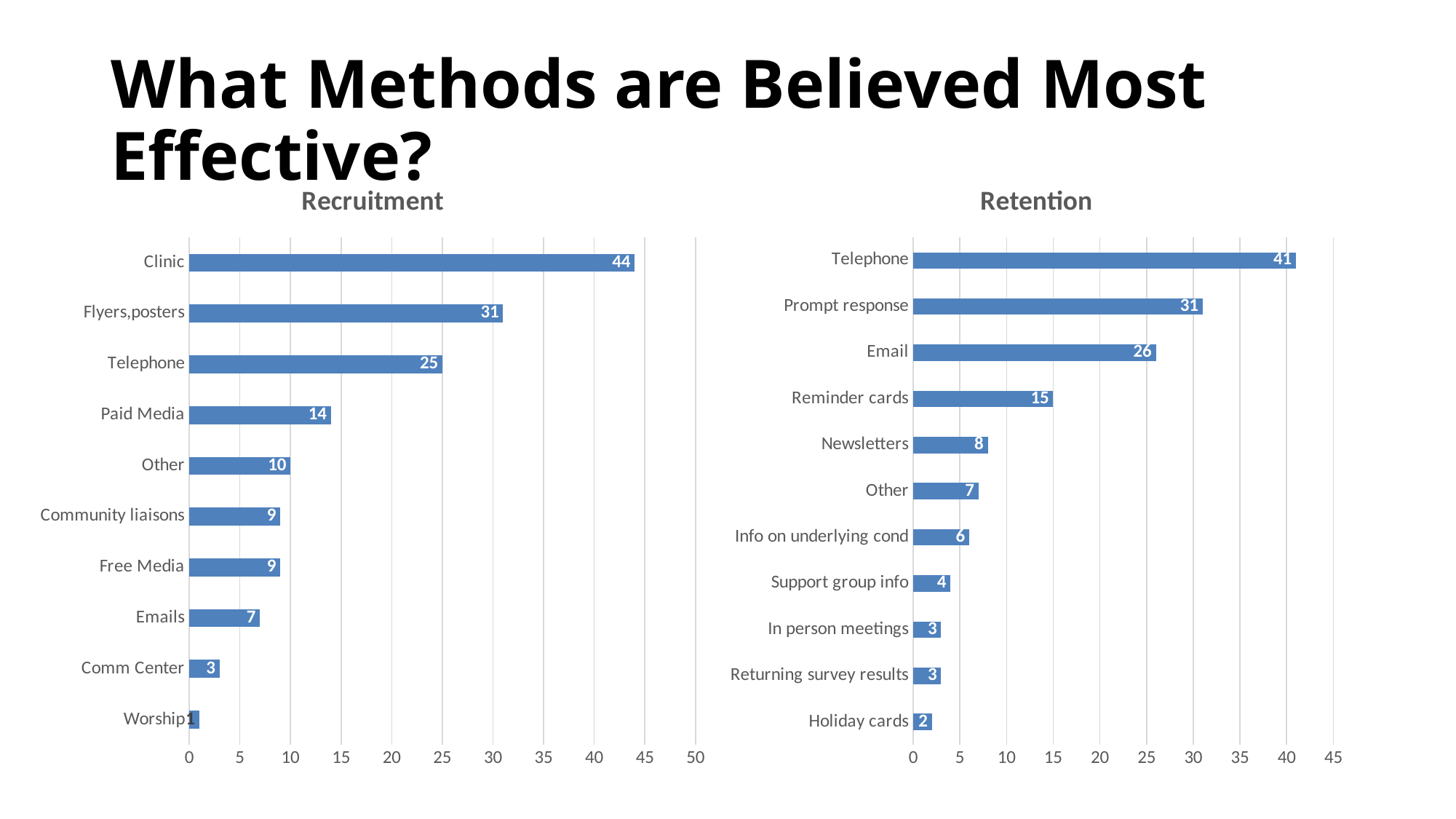
In the Retention chart, what is the difference between Prompt response and Reminder cards? 16 In the Retention chart, is the value for Telephone greater or less than 40? greater In the Retention chart, what is the value for Email? 26 How many categories does the Recruitment chart show? 10 How many categories does the Retention chart show? 11 In the Recruitment chart, what is the value for Clinic? 44 In the Recruitment chart, which is larger, Telephone or Paid Media? Telephone In the Retention chart, which category has the highest value? Telephone What is the title of the chart on the left side of the slide? Recruitment In the Recruitment chart, which category has the lowest value? Worship In the Recruitment chart, what is the difference between Clinic and Flyers,posters? 13 What kind of chart is the Retention chart? Bar chart